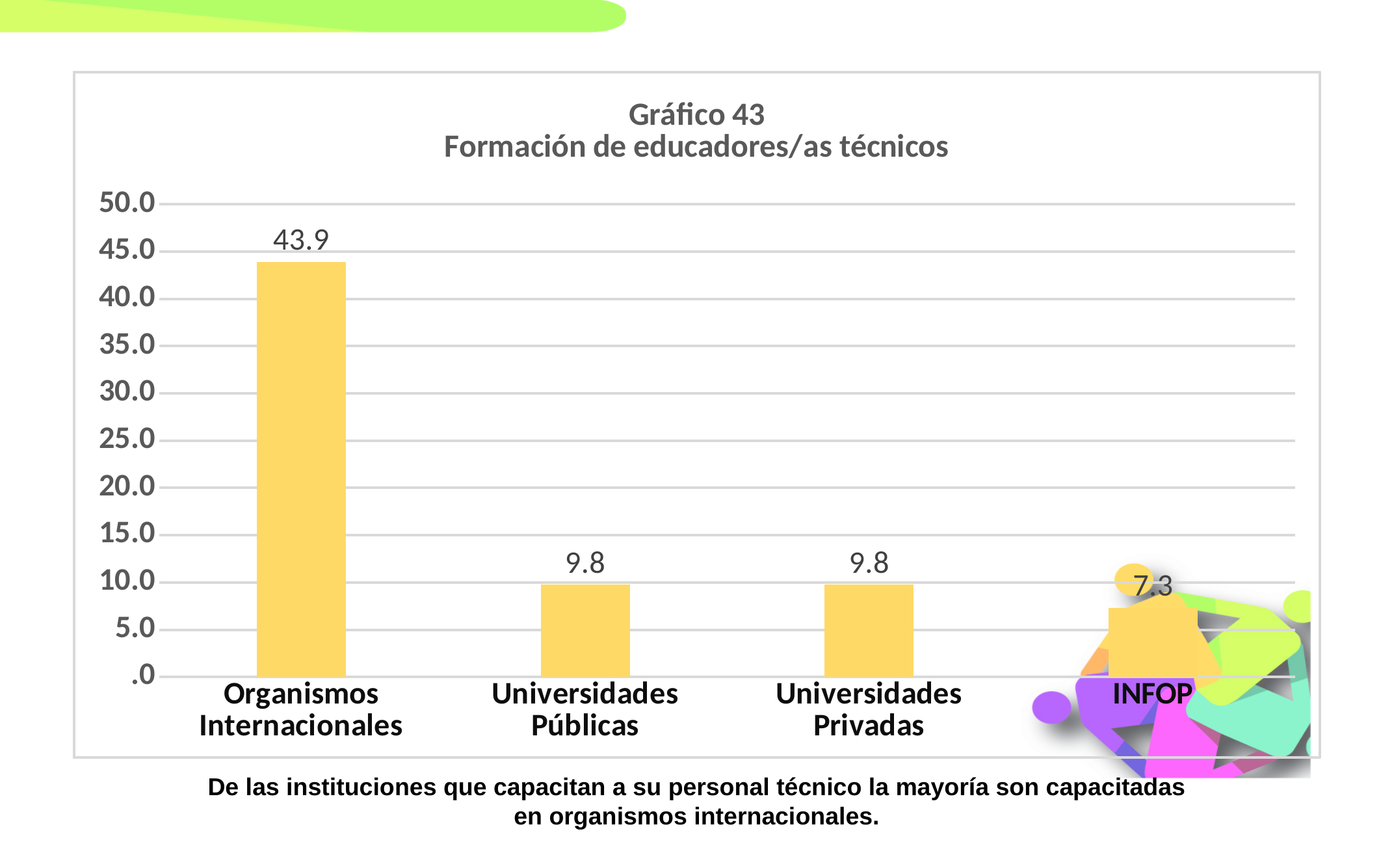
Which is larger, the value for Universidades Privadas or the value for INFOP? Universidades Privadas Which category has the lowest value? INFOP What is the value for INFOP? 7.3 What is the value for Universidades Públicas? 9.8 What is the value for Organismos Internacionales? 43.9 Which category has the highest value? Organismos Internacionales What is the title of the chart? Gráfico 43 Formación de educadores/as técnicos How many categories are shown on the x axis? 4 Is the value for Organismos Internacionales greater or less than 40.0? greater What kind of chart is shown on the slide? bar chart What is the difference between the values for Organismos Internacionales and Universidades Privadas? 34.1 What is the difference between the values for Universidades Públicas and INFOP? 2.5